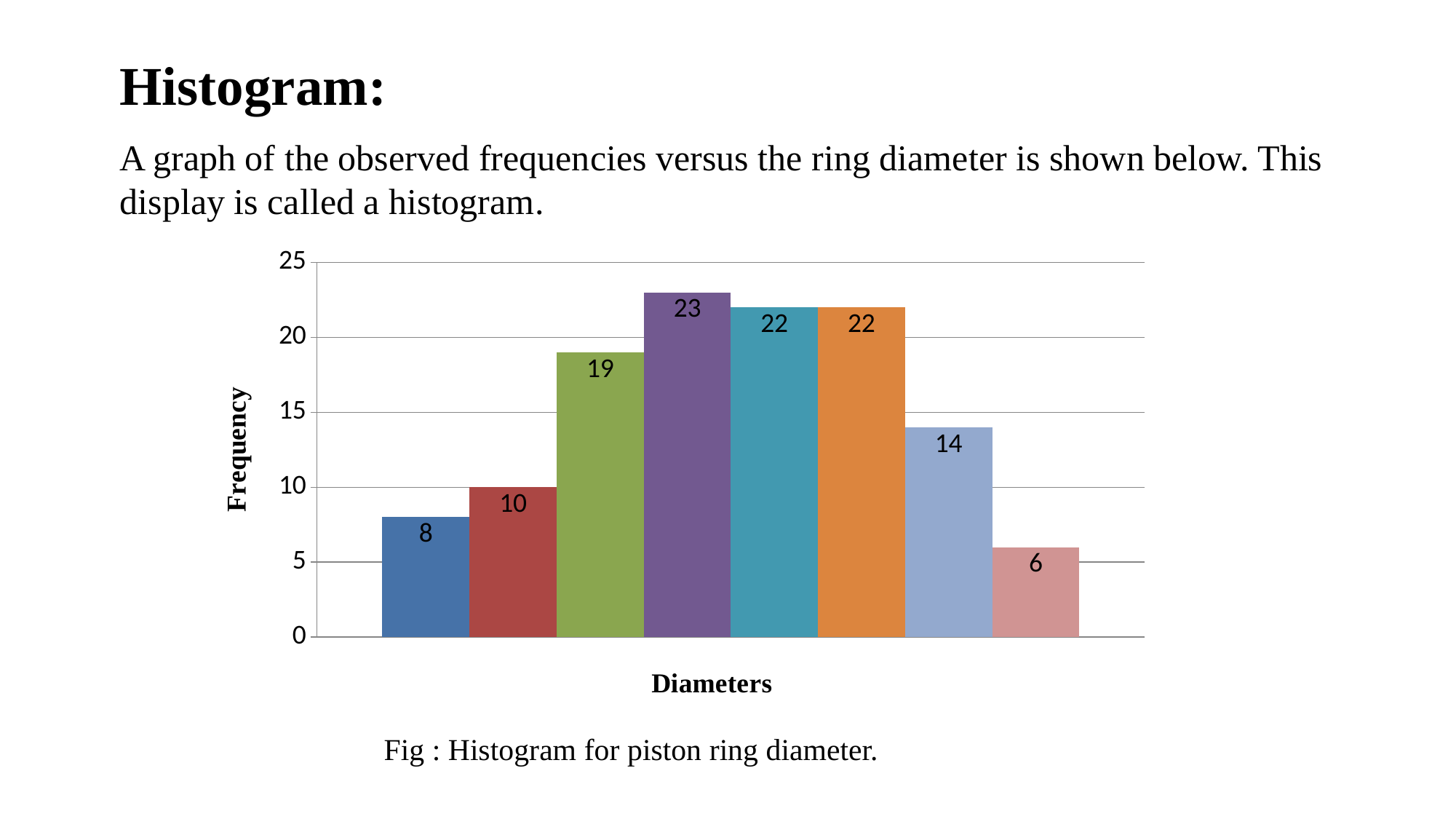
What is the frequency shown by the first (leftmost) bar? 8 What is the difference between the frequency of the fourth bar (23) and the third bar (19)? 4 What type of chart is shown on the slide? Bar chart What is the total of all the frequencies shown in the histogram? 124 What is the label of the horizontal axis? Diameters Which is larger, the frequency of the second bar or the seventh bar? The seventh bar (14) What is the frequency shown by the tallest bar? 23 What is the frequency shown by the green bar? 19 How many bars are plotted in the histogram? 8 What is the lowest frequency value shown in the chart? 6 What is the label of the vertical axis? Frequency What is the frequency shown by the last (rightmost) bar? 6